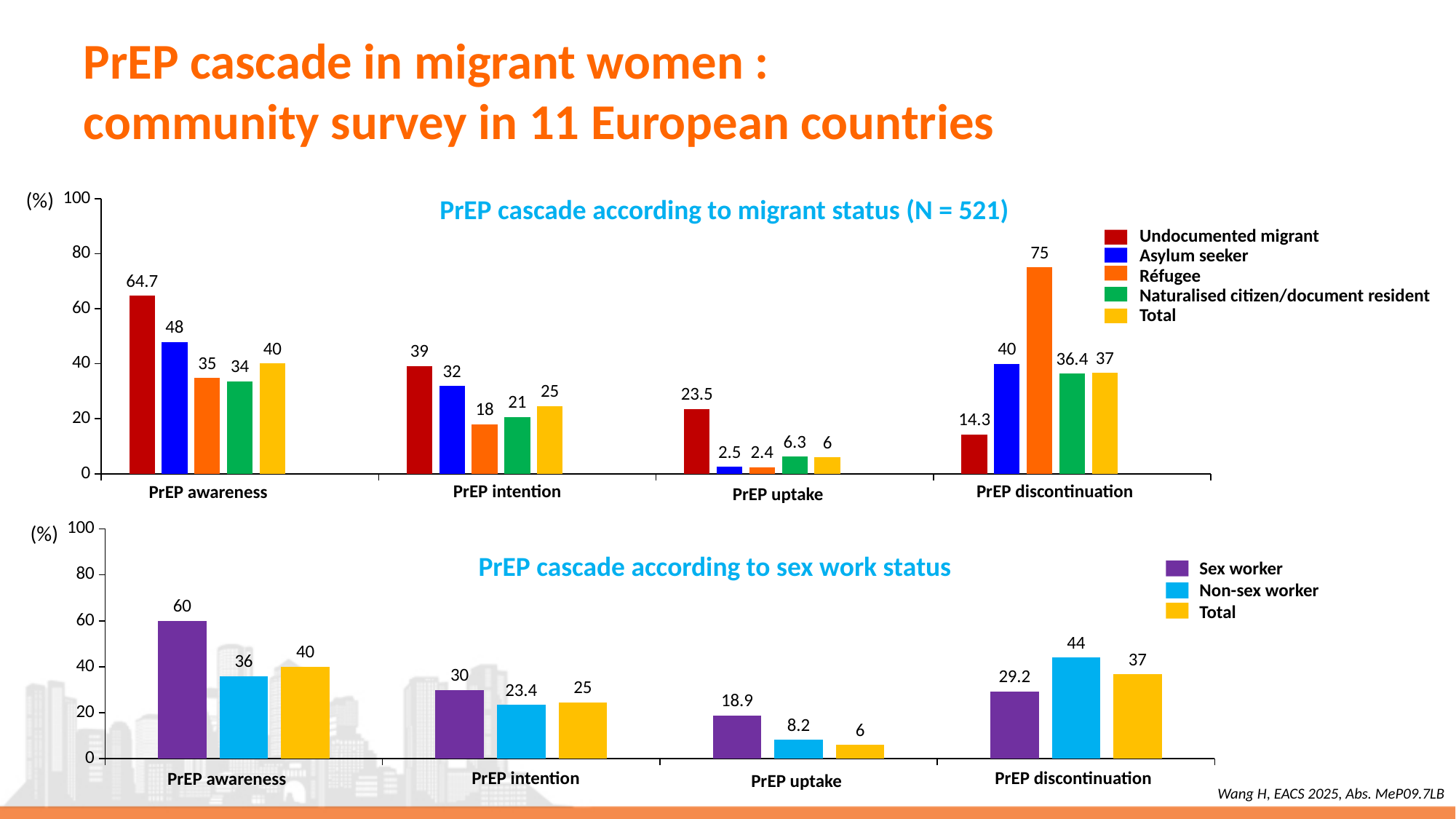
In the 'PrEP cascade according to migrant status' chart, what is the value for Undocumented migrant at PrEP awareness? 64.7 How many series does the legend of the 'PrEP cascade according to migrant status' chart list? 5 In the 'PrEP cascade according to sex work status' chart, what is the difference between the Sex worker and Non-sex worker values for PrEP awareness? 24 In the 'PrEP cascade according to migrant status' chart, what is the difference between the Undocumented migrant and Asylum seeker values for PrEP awareness? 16.7 In the 'PrEP cascade according to sex work status' chart, which is larger at PrEP intention: Sex worker or Non-sex worker? Sex worker What kind of chart is the 'PrEP cascade according to sex work status' chart? Bar chart In the 'PrEP cascade according to migrant status' chart, which migrant status group has the lowest PrEP uptake? Réfugee In the 'PrEP cascade according to sex work status' chart, what is the value for Sex worker at PrEP uptake? 18.9 In the 'PrEP cascade according to migrant status' chart, what is the value for Réfugee at PrEP discontinuation? 75 In the 'PrEP cascade according to migrant status' chart, which migrant status group has the highest PrEP uptake? Undocumented migrant How many categories are shown on the x axis of the 'PrEP cascade according to sex work status' chart? 4 In the 'PrEP cascade according to sex work status' chart, what is the value for Non-sex worker at PrEP discontinuation? 44